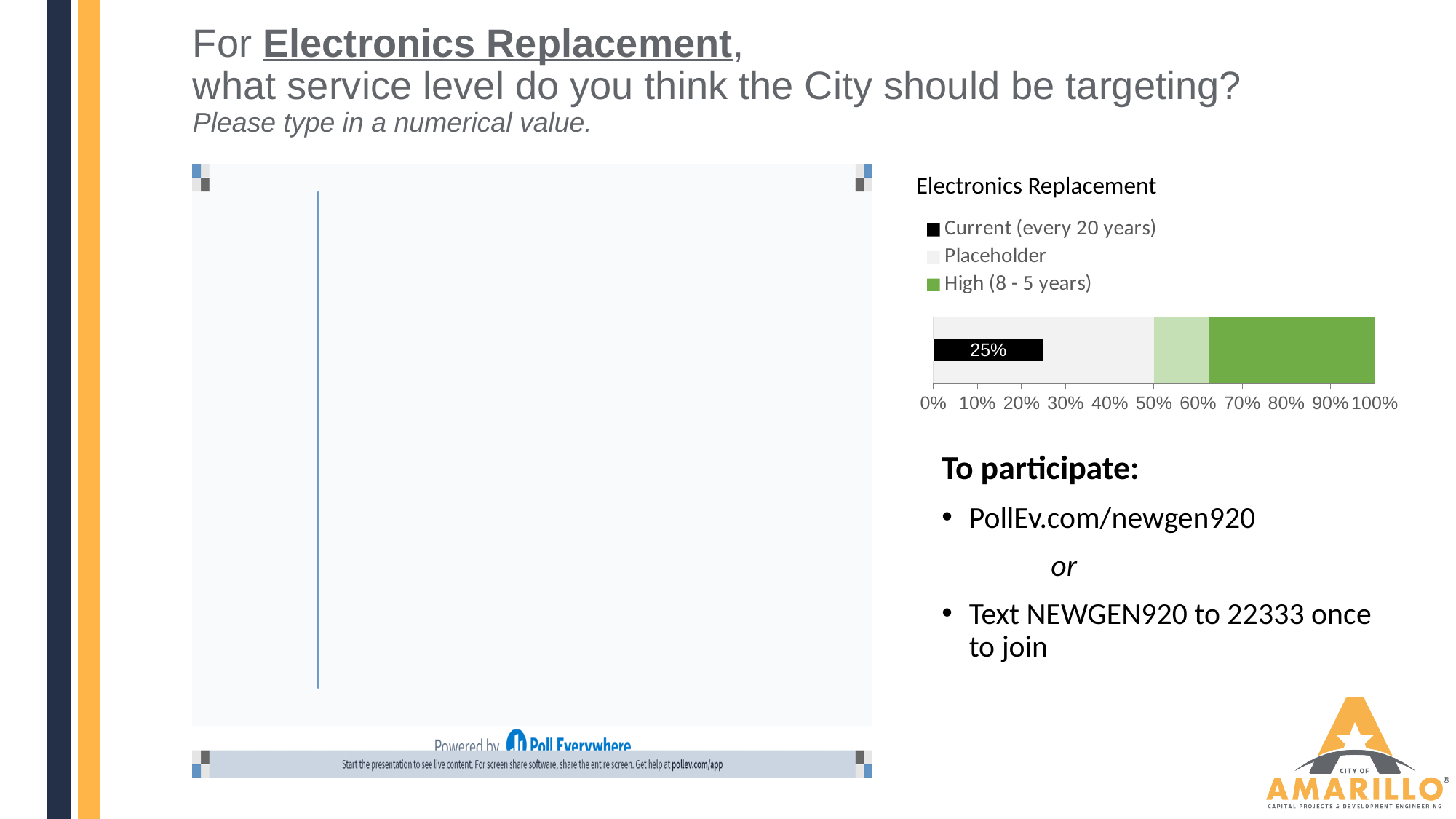
In the Electronics Replacement chart, what value is labeled on the Current (every 20 years) segment? 25% In the Electronics Replacement chart, which legend entry is shown in black? Current (every 20 years) In the Electronics Replacement chart, is the value for Current (every 20 years) greater or less than 20%? greater What is the title of the chart on the right side of the slide? Electronics Replacement In the Electronics Replacement chart, is the value for Current (every 20 years) greater or less than 30%? less How many series does the legend of the Electronics Replacement chart list? 3 In the Electronics Replacement chart, which legend entry is shown in green? High (8 - 5 years) What kind of chart is the Electronics Replacement chart? bar chart